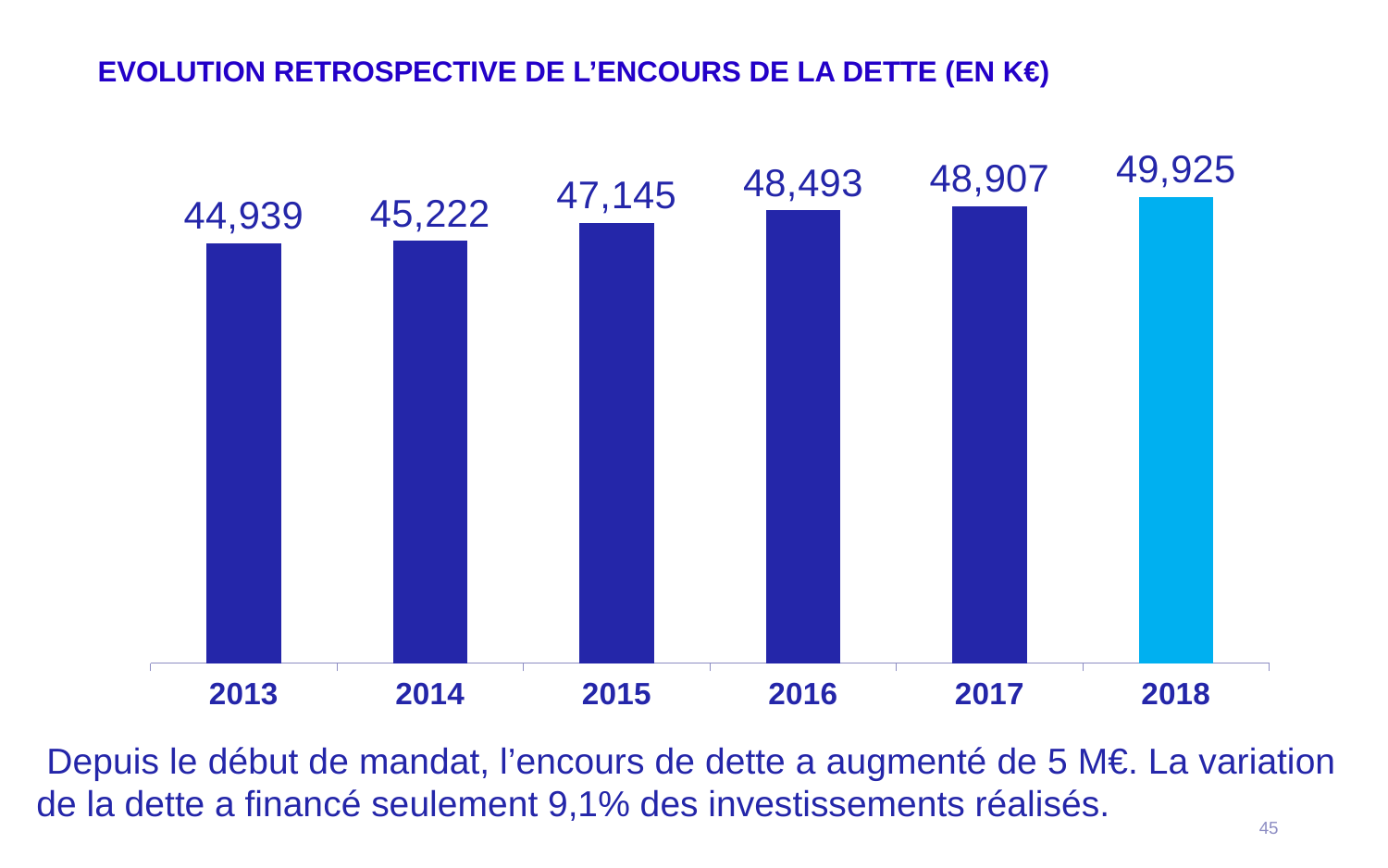
What kind of chart is this? Bar chart Which year's bar is shown in a lighter blue colour than the others? 2018 What is the value for 2018? 49,925 What is the difference between the values for 2015 and 2014? 1,923 Which year has the lowest value? 2013 What is the value for 2016? 48,493 Which is larger, the value for 2017 or the value for 2015? 2017 What is the value for 2013? 44,939 How many years are shown on the x axis? 6 What is the difference between the values for 2018 and 2013? 4,986 Do the values rise or fall from 2013 to 2018? Rise Which year has the highest value? 2018